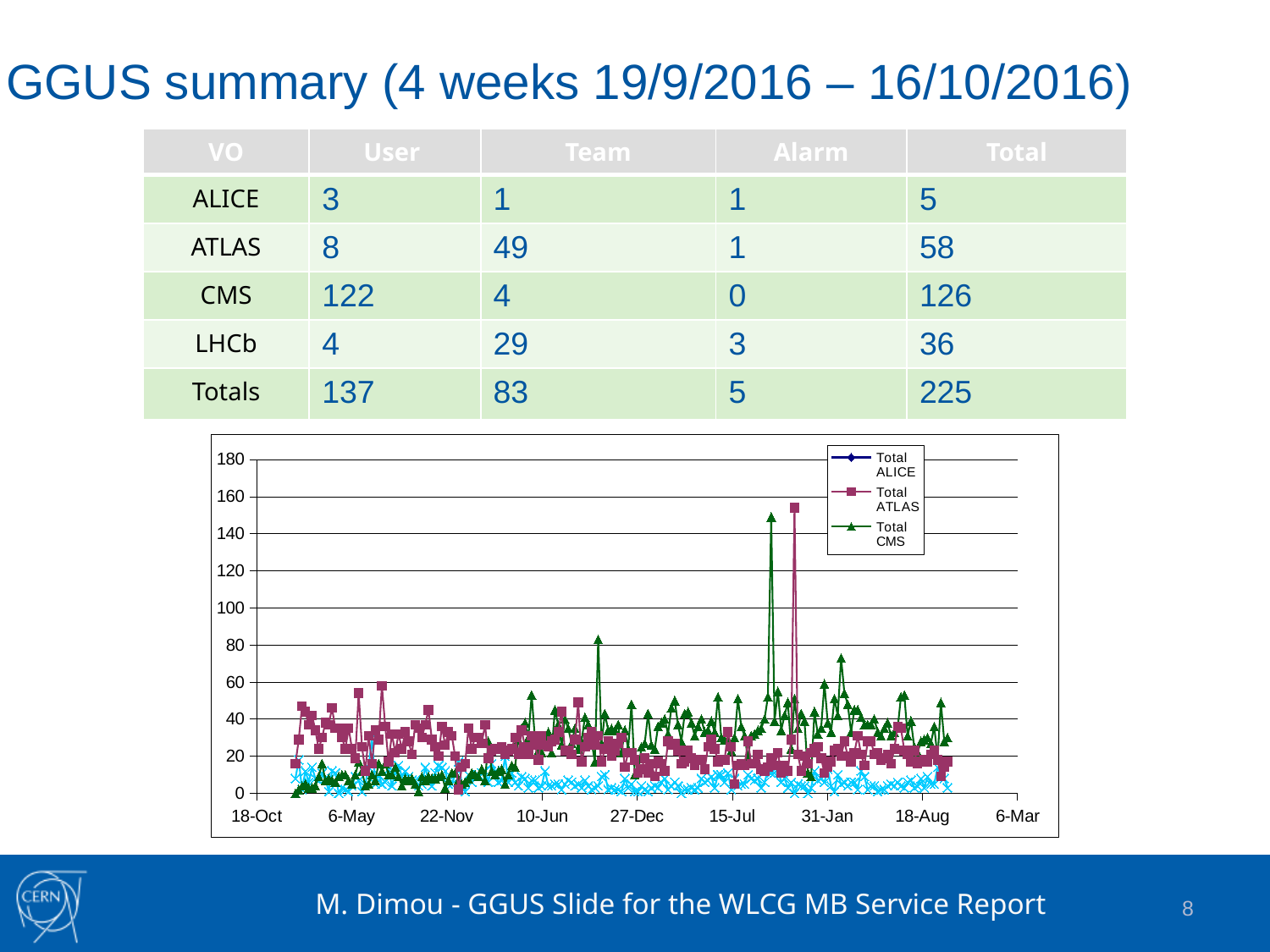
Is the highest peak of the Total CMS series greater or less than 100? greater What kind of chart is shown on the slide? line chart What is the highest value shown on the chart's vertical axis? 180 Is the highest peak of the Total CMS series greater or less than 160? less How many series does the chart's legend list? 3 Which series has higher values overall, Total ALICE or Total CMS? Total CMS How many date labels are shown along the chart's horizontal axis? 9 Is the highest peak of the Total ATLAS series greater or less than 140? greater What is the first date label on the chart's horizontal axis? 18-Oct Which series in the chart has the lowest values overall? Total ALICE What are the three series named in the chart's legend? Total ALICE, Total ATLAS, Total CMS